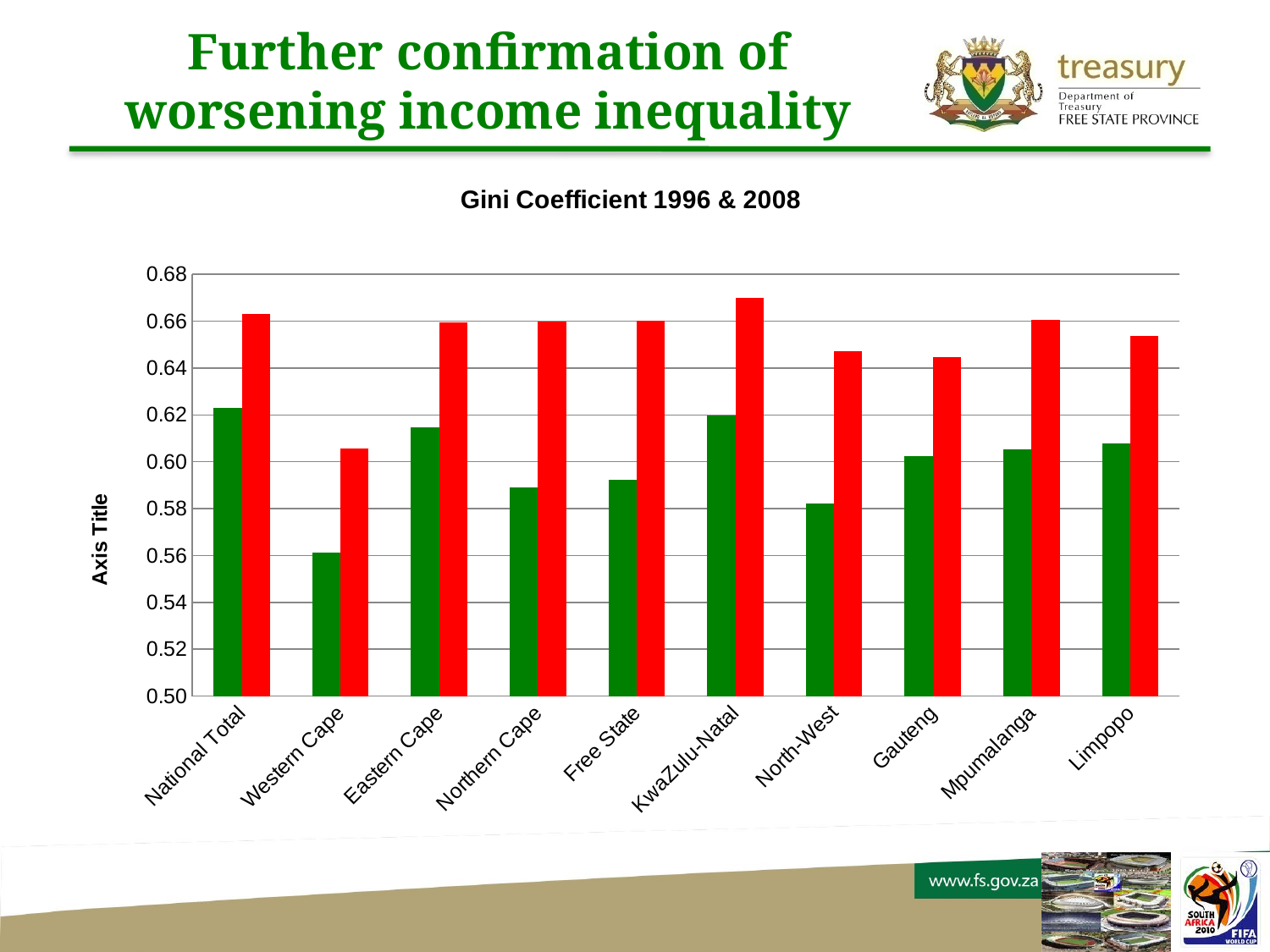
Is the red bar for KwaZulu-Natal greater or less than 0.66? greater What is the title of the chart? Gini Coefficient 1996 & 2008 Which category has the highest red bar? KwaZulu-Natal What two colours are used for the bars in the chart? Green and red What type of chart is shown on the slide? Bar chart Is the green bar for Western Cape greater or less than 0.58? less Which is larger, the green bar for Western Cape or the green bar for Eastern Cape? Eastern Cape Is the green bar for North-West greater or less than 0.60? less In the Free State category, which bar is taller, the green bar or the red bar? The red bar Which category has the lowest green bar? Western Cape How many categories are shown on the x axis of the chart? 10